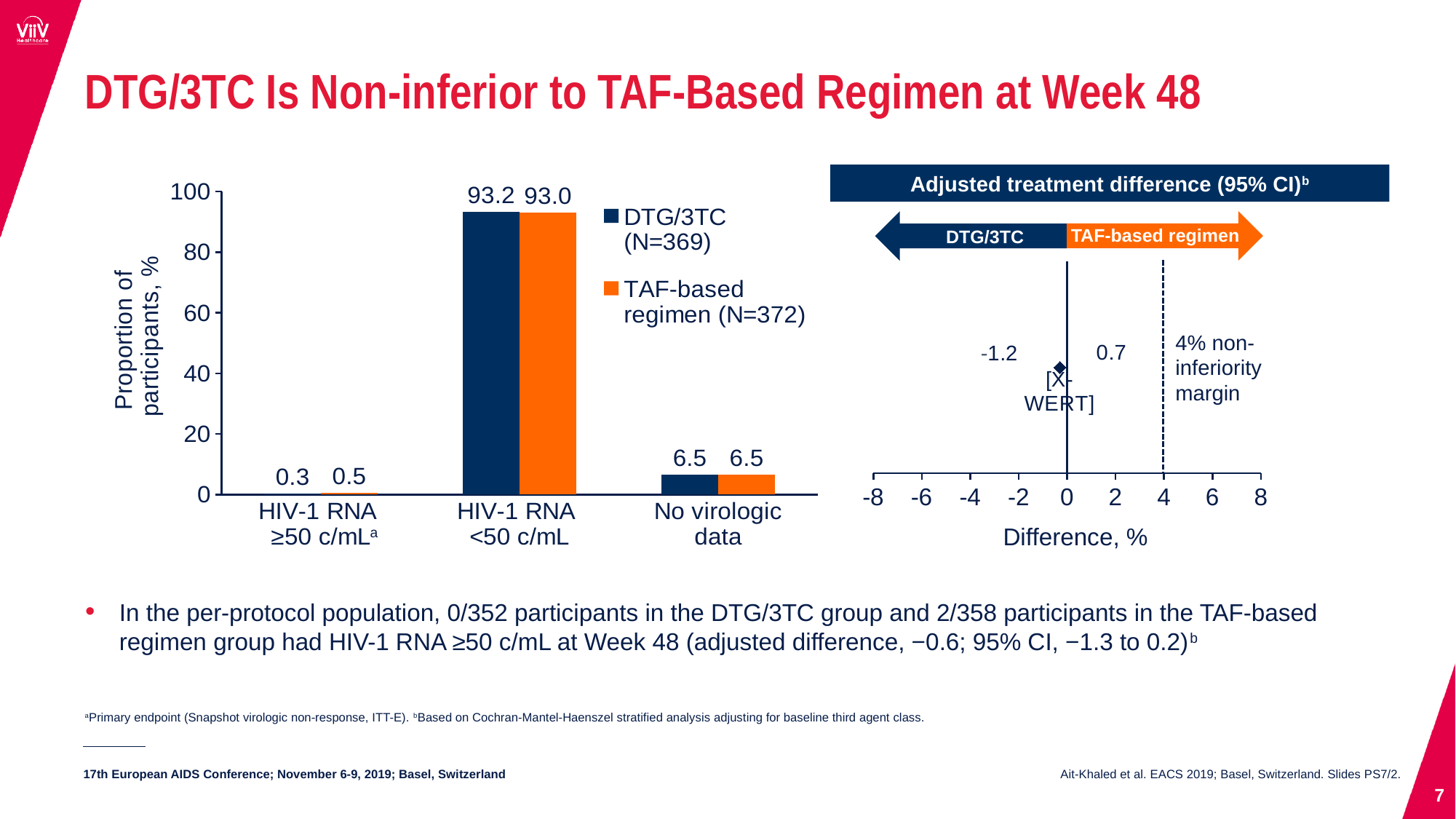
In the bar chart on the left, what is the difference between the DTG/3TC and TAF-based regimen values in the HIV-1 RNA <50 c/mL category? 0.2 How many categories are shown on the x axis of the bar chart on the left? 3 In the bar chart on the left, which series has the larger value in the HIV-1 RNA ≥50 c/mL category? TAF-based regimen In the bar chart on the left, which category has the highest value for DTG/3TC? HIV-1 RNA <50 c/mL In the Adjusted treatment difference chart on the right, at what value is the non-inferiority margin drawn? 4% In the bar chart on the left, what is the value for DTG/3TC in the No virologic data category? 6.5 In the bar chart on the left, what is the value for DTG/3TC in the HIV-1 RNA <50 c/mL category? 93.2 In the Adjusted treatment difference chart on the right, what are the lower and upper bounds of the 95% CI shown? -1.2 and 0.7 How many series does the legend of the bar chart on the left list? 2 What kind of chart is the chart on the left of the slide? Bar chart What is the y-axis title of the bar chart on the left? Proportion of participants, % In the bar chart on the left, what is the value for the TAF-based regimen in the HIV-1 RNA ≥50 c/mL category? 0.5